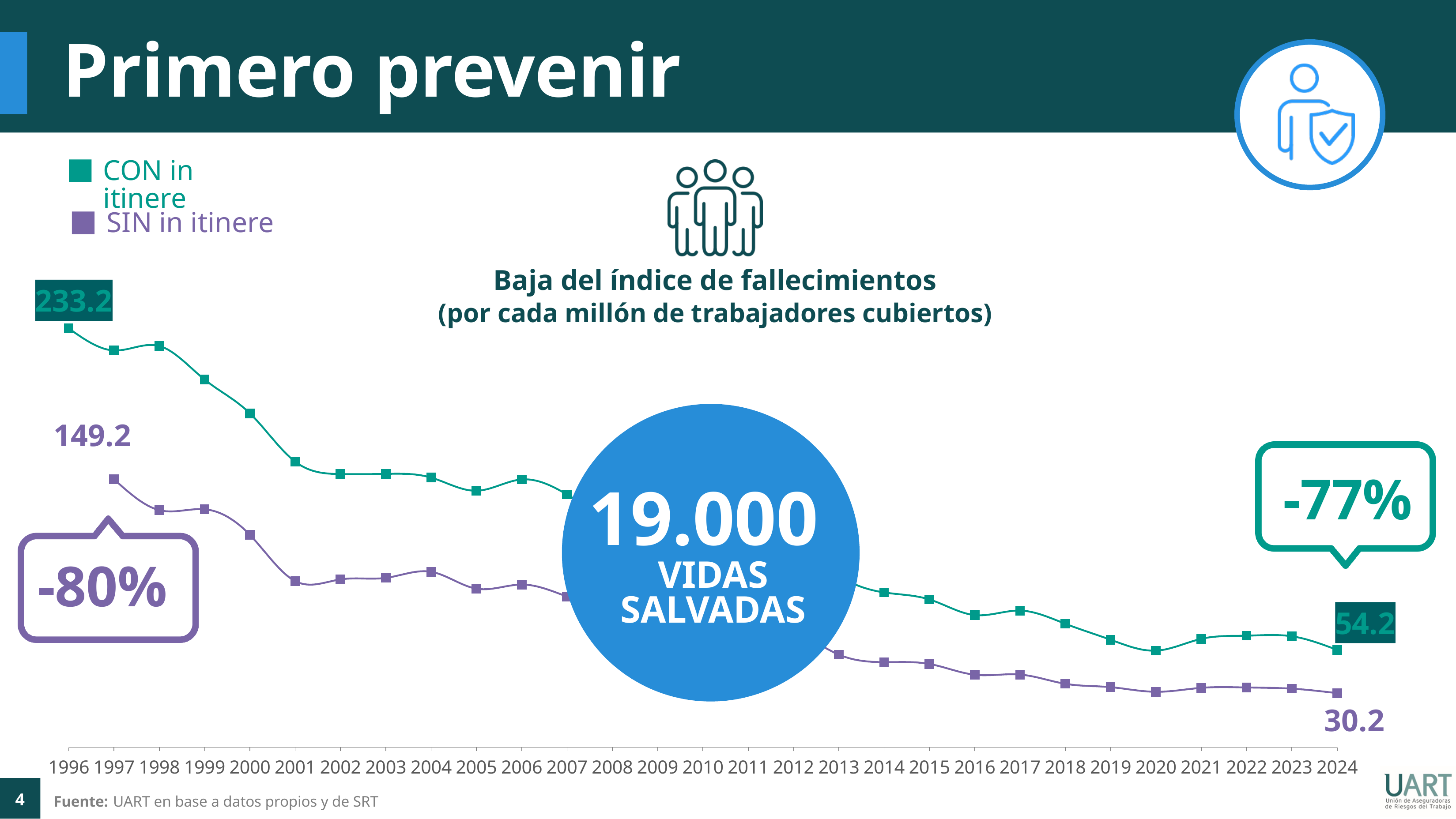
What kind of chart is shown on the slide? line chart What is the difference between the CON in itinere and SIN in itinere values in 2024? 24.0 Do the values of the CON in itinere series generally rise or fall from 1996 to 2024? fall What is the value of the CON in itinere series in 2024? 54.2 In 2024, which series has the higher value, CON in itinere or SIN in itinere? CON in itinere What is the value of the SIN in itinere series in 2024? 30.2 What is the first labelled value of the SIN in itinere series? 149.2 By how much did the CON in itinere value fall from 1996 to 2024? 179.0 What percentage change is shown in the callout for the SIN in itinere series? -80% How many series does the legend list? 2 How many years are labelled on the x axis? 29 What is the value of the CON in itinere series in 1996? 233.2